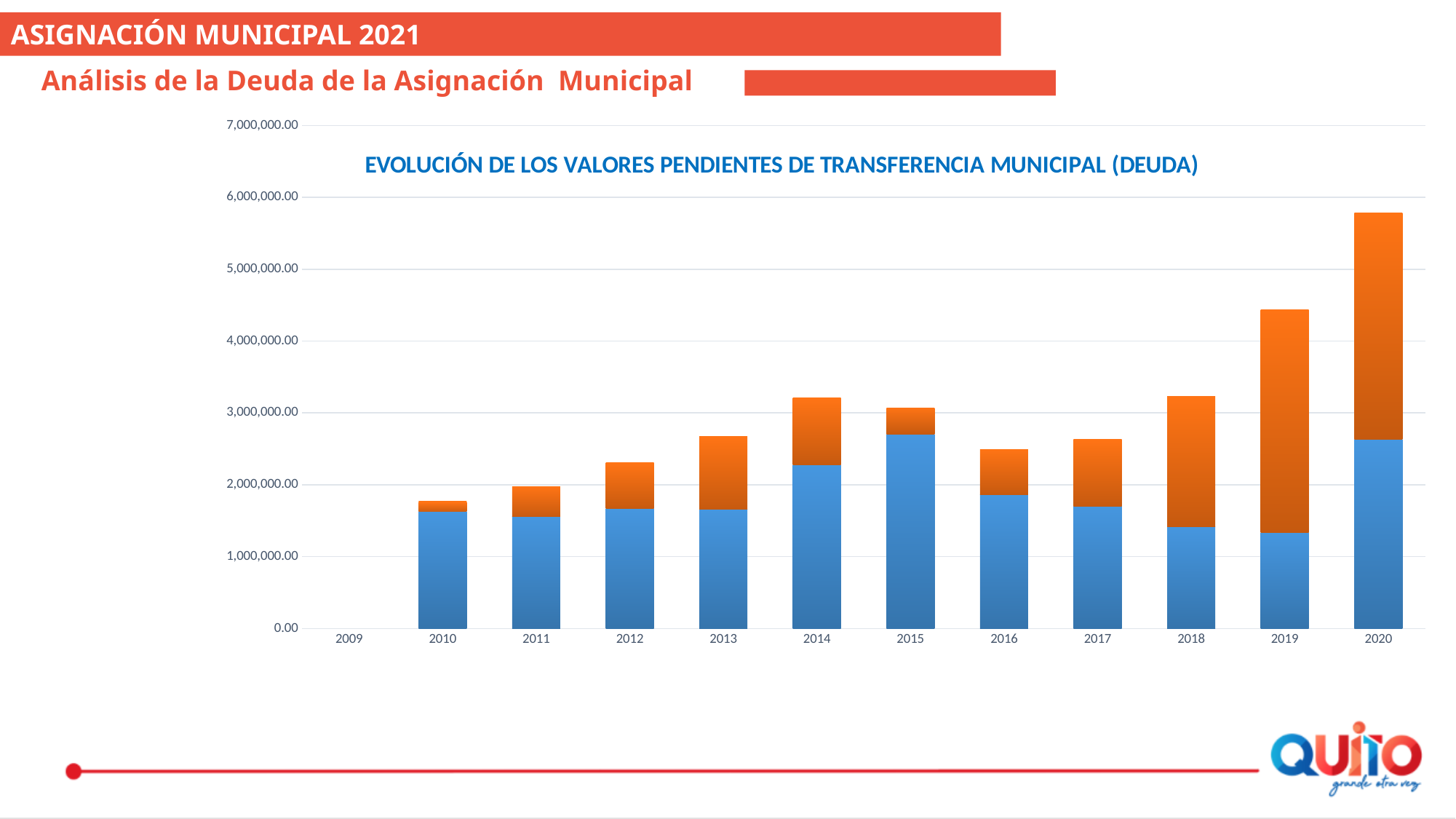
Which year has a larger total bar, 2018 or 2019? 2019 What is the title of the chart? EVOLUCIÓN DE LOS VALORES PENDIENTES DE TRANSFERENCIA MUNICIPAL (DEUDA) Is the total value for 2016 greater or less than 3,000,000.00? less Which year on the x axis shows no bar at all? 2009 Is the total value for 2020 greater or less than 5,000,000.00? greater Among the years with a visible bar, which year has the lowest total? 2010 How many years are shown on the x axis of the chart? 12 Is the total value for 2019 greater or less than 4,000,000.00? greater Do the total bar values rise or fall from 2016 to 2020? rise What kind of chart is shown on the slide? Stacked bar chart Which year has the highest total bar? 2020